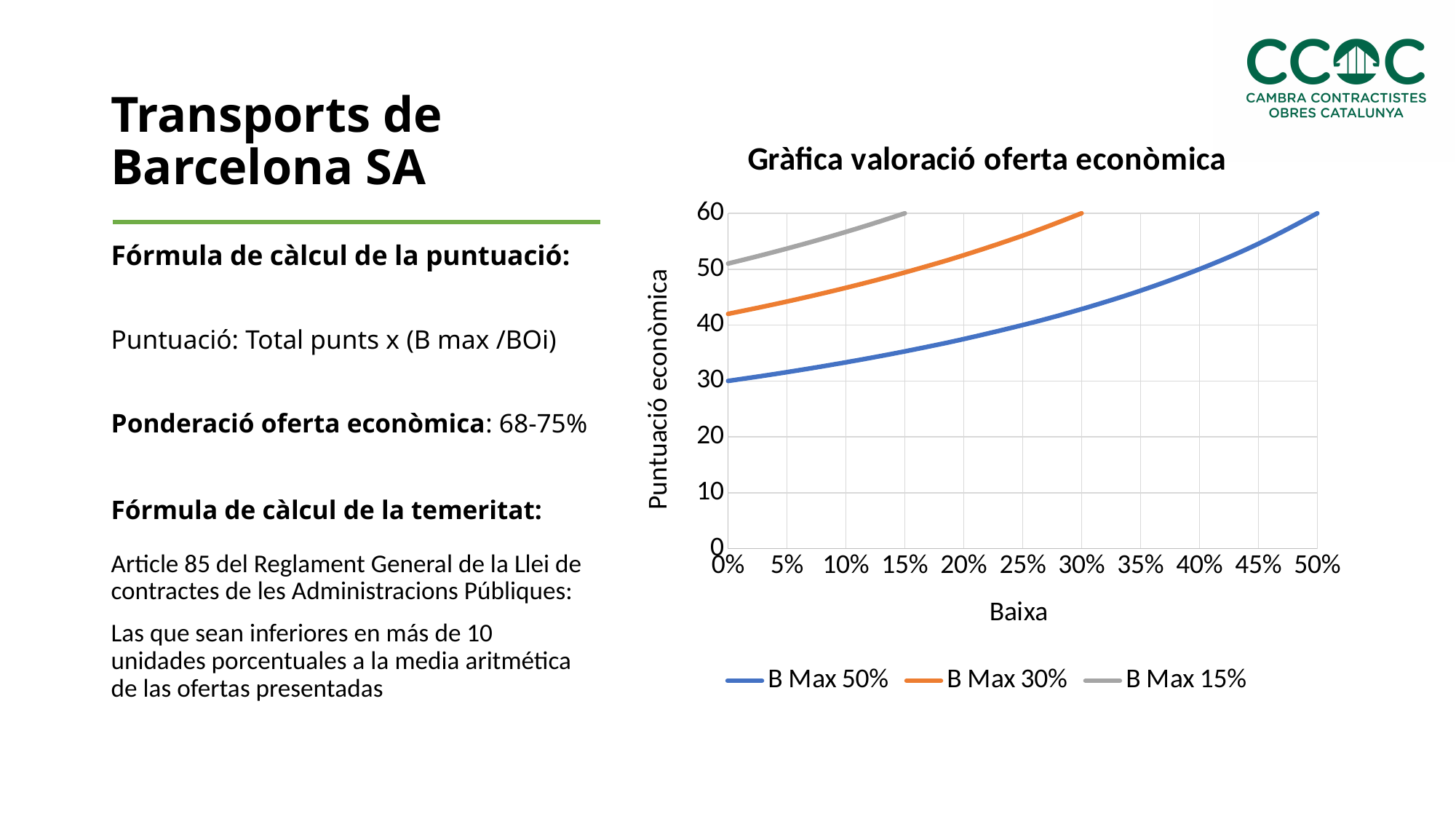
What value does the B Max 30% line reach at a Baixa of 30%? 60 Is the value of the B Max 15% line at a Baixa of 0% greater or less than 40? greater What is the label of the x axis of the chart? Baixa At a Baixa of 0%, which series has the lowest Puntuació econòmica? B Max 50% What kind of chart is shown on the slide? line chart Do the lines rise or fall as Baixa increases along the x axis? rise What value does the B Max 15% line reach at a Baixa of 15%? 60 What value does the B Max 50% line reach at a Baixa of 50%? 60 At a Baixa of 10%, which line is higher, B Max 15% or B Max 50%? B Max 15% How many series does the legend of the chart list? 3 Is the value of the B Max 50% line at a Baixa of 0% greater or less than 40? less What is the title of the chart? Gràfica valoració oferta econòmica